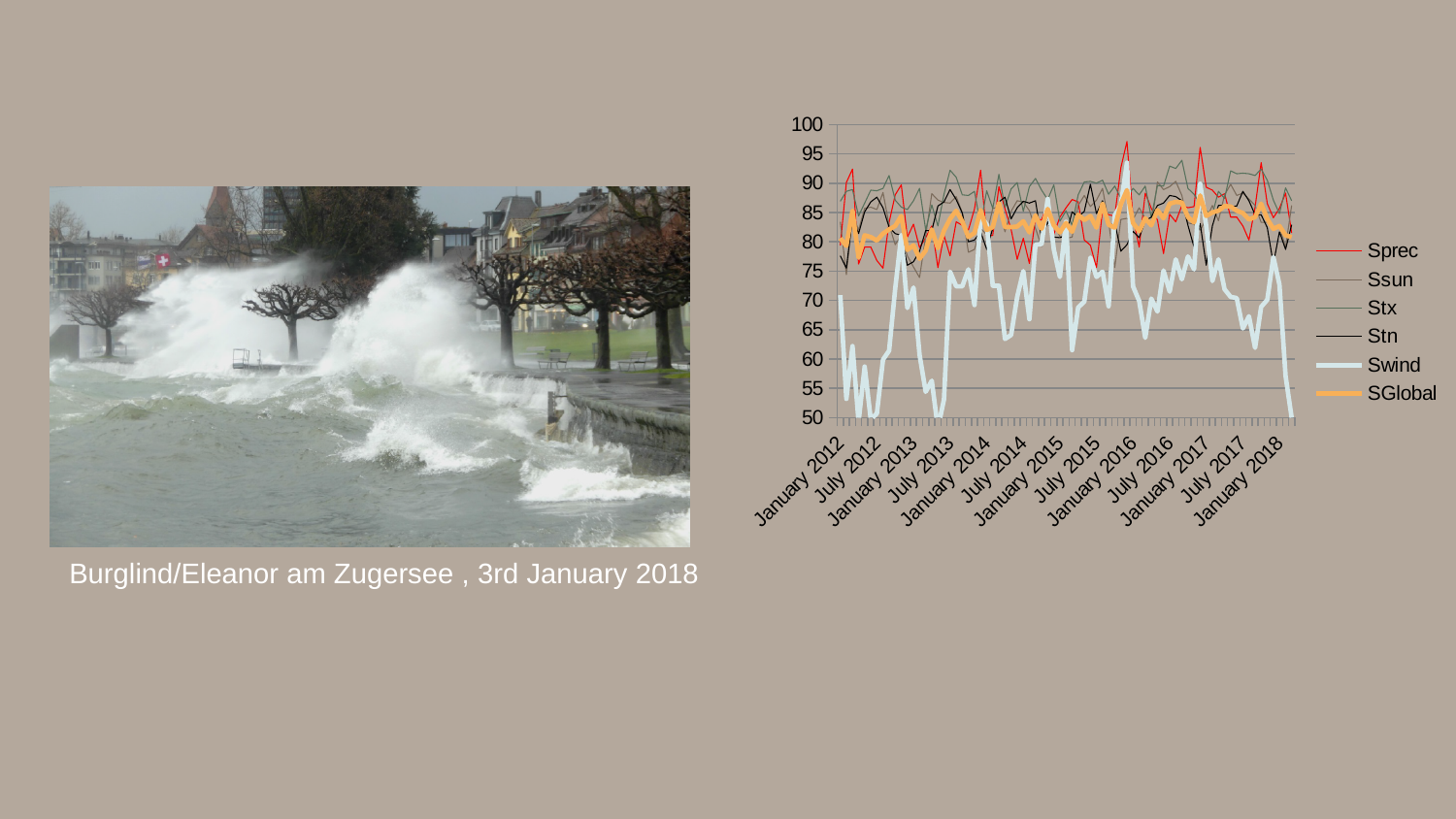
At January 2018, which is higher, Swind or SGlobal? SGlobal How many series does the chart's legend list? 6 Does the Swind series rise or fall toward January 2018 at the end of the chart? fall Is the value of Swind at January 2018 greater or less than 60? greater What is the last label on the chart's horizontal axis? January 2018 What is the first label on the chart's horizontal axis? January 2012 Is the value of Swind at January 2012 greater or less than 60? greater What is the highest value shown on the chart's vertical axis? 100 Which series is drawn in orange in the chart? SGlobal Which series is drawn in red in the chart? Sprec What is the lowest value shown on the chart's vertical axis? 50 What kind of chart is shown on the slide? line chart